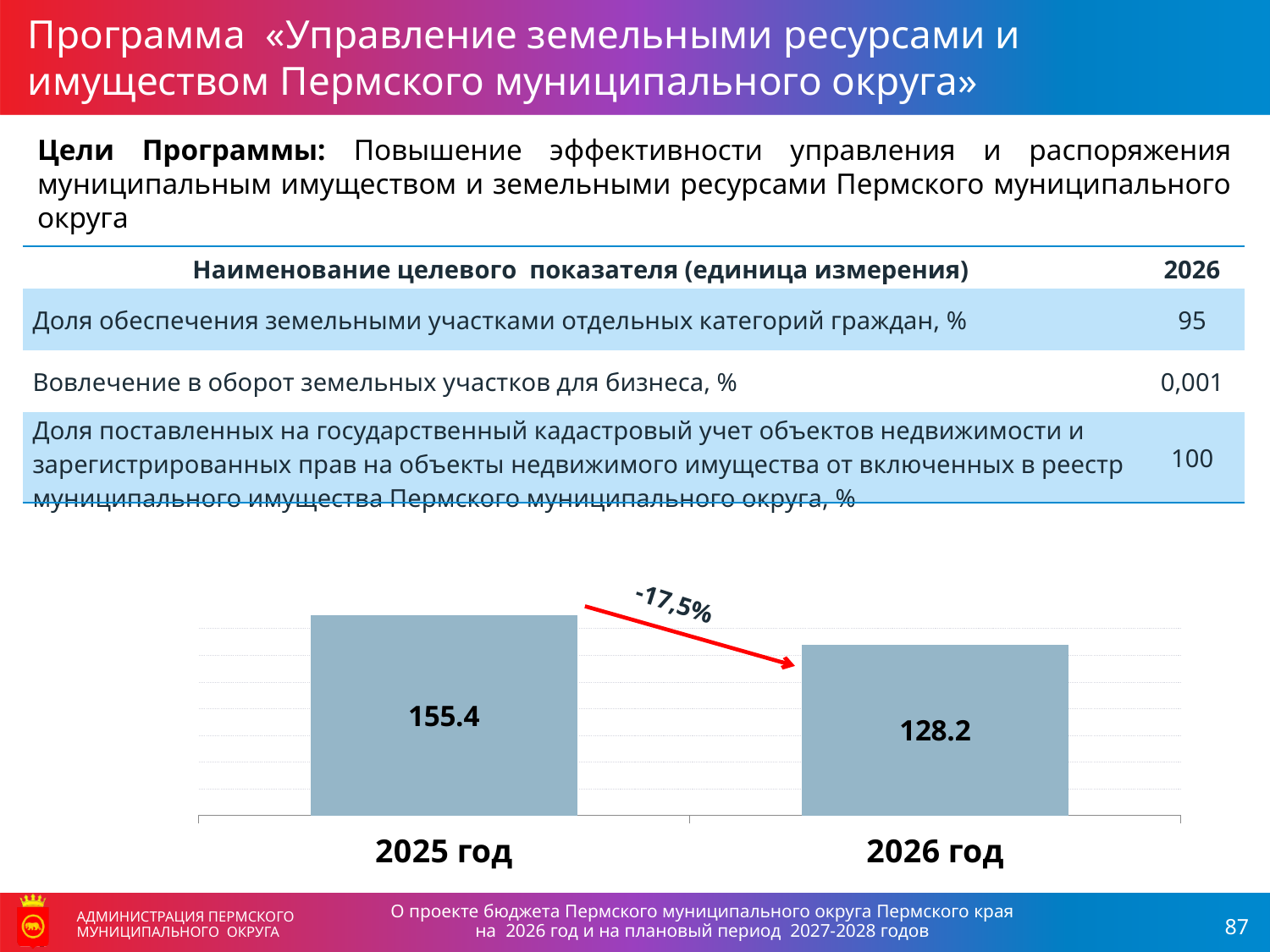
Do the values rise or fall from 2025 год to 2026 год? fall What colour are the bars in the chart? grey-blue What percentage change is written next to the arrow between the two bars? -17,5% What is the difference between the values for 2025 год and 2026 год? 27.2 How many bars are plotted in the chart? 2 Is the value for 2025 год larger or smaller than the value for 2026 год? larger What is the value shown for 2026 год in the bar chart? 128.2 Which year has the lower bar in the chart? 2026 год Which year has the higher bar in the chart? 2025 год What is the value shown for 2025 год in the bar chart? 155.4 What type of chart is shown on the slide? bar chart